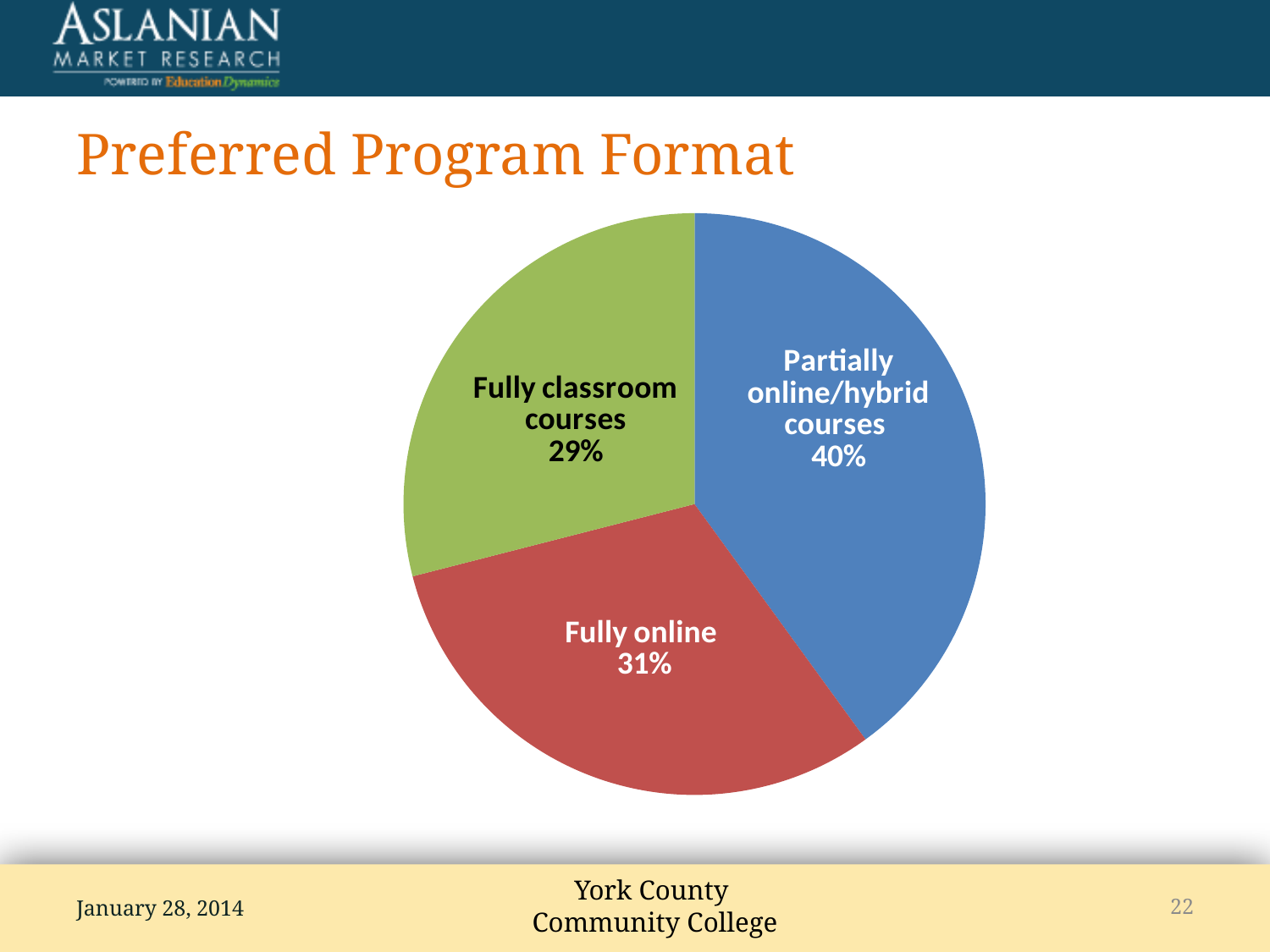
What share of the pie is Fully classroom courses? 29% Which program format has the largest share of the pie? Partially online/hybrid courses What is the title of the chart on the slide? Preferred Program Format What share of the pie is Fully online? 31% What colour is the Fully online slice? Red What is the difference in percentage points between Fully online and Fully classroom courses? 2 What is the difference in percentage points between Partially online/hybrid courses and Fully classroom courses? 11 What kind of chart is shown on the slide? Pie chart Which is larger, the share for Fully online or the share for Partially online/hybrid courses? Partially online/hybrid courses Which program format has the smallest share of the pie? Fully classroom courses How many slices does the pie chart have? 3 What share of the pie is Partially online/hybrid courses? 40%